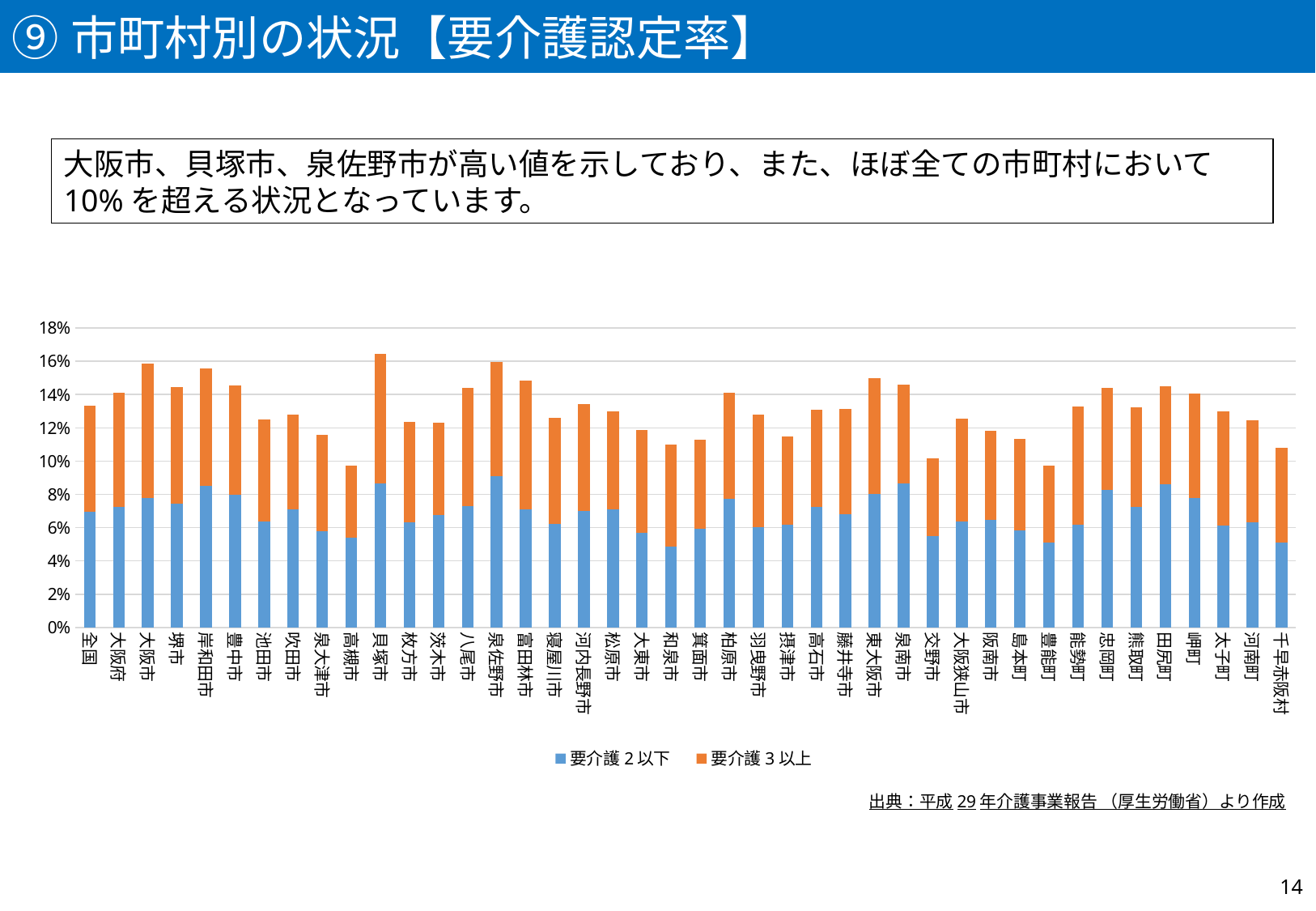
Which has the larger total bar, 貝塚市 or 高槻市? 貝塚市 What kind of chart is shown on the slide? Stacked bar chart Which series is shown in orange in the legend? 要介護3以上 Is the total value for 和泉市 greater or less than 12%? less How many series does the legend list? 2 What is the first legend entry (shown in blue)? 要介護2以下 Is the total value for 大阪市 greater or less than 14%? greater Which has the larger total bar, 大阪市 or 堺市? 大阪市 Is the total value for 貝塚市 greater or less than 14%? greater Which category has the highest total bar? 貝塚市 How many municipalities/categories are plotted along the x axis? 42